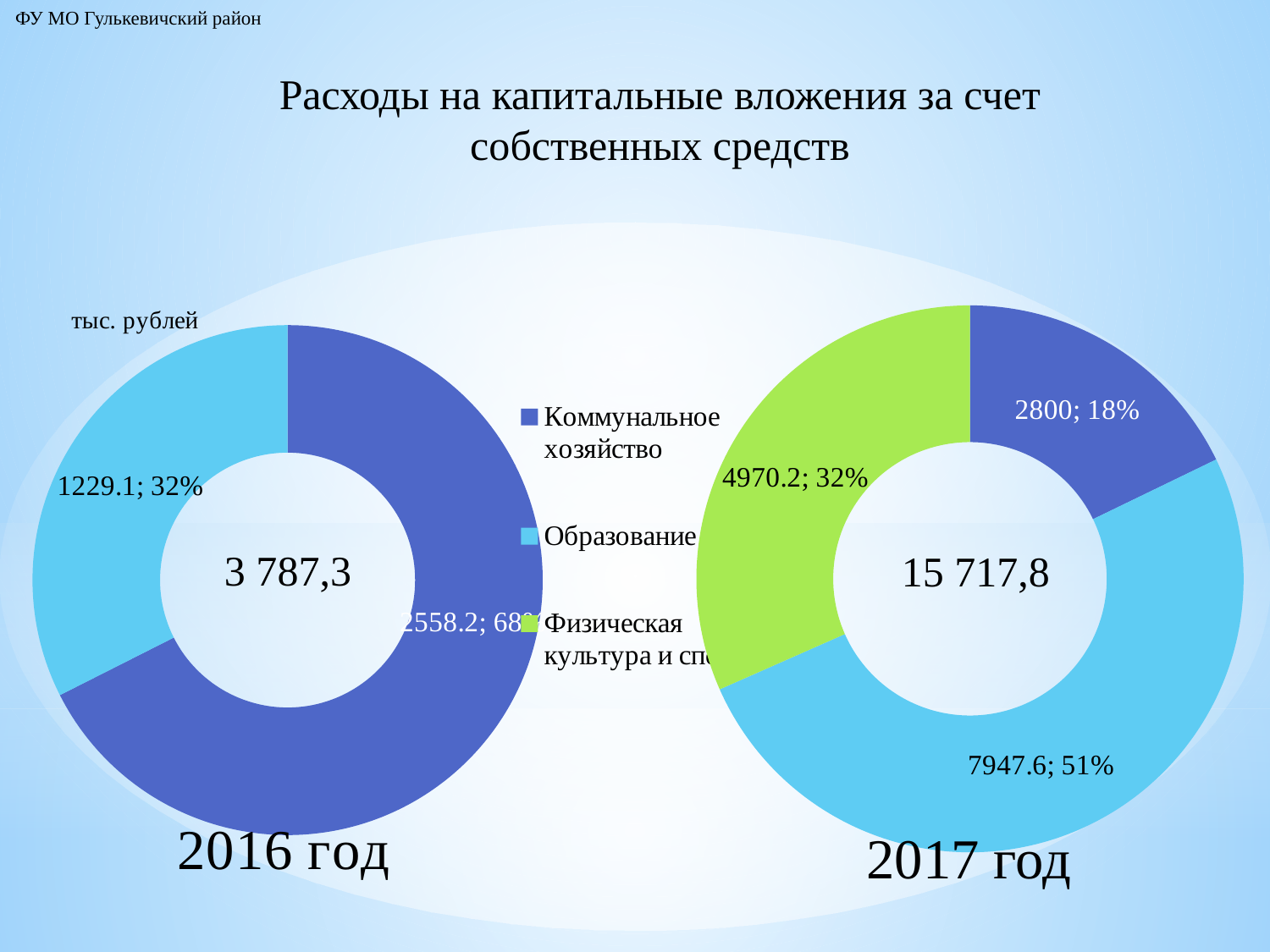
What type of chart is used on this slide? Pie (doughnut) chart How many slices does the 2017 год chart have? 3 How many slices does the 2016 год chart have? 2 On the 2017 год chart, which is larger: Физическая культура и спорт or Коммунальное хозяйство? Физическая культура и спорт On the 2017 год chart, what is the value for Физическая культура и спорт? 4970.2 On the 2016 год chart, what is the value for Образование? 1229.1 On the 2017 год chart, what share of the total does Коммунальное хозяйство represent? 18% On the 2017 год chart, what is the difference between the values for Образование and Физическая культура и спорт? 2977.4 On the 2017 год chart, which category has the smallest slice? Коммунальное хозяйство On the 2017 год chart, which category has the largest slice? Образование On the 2016 год chart, what share of the total does Образование represent? 32% On the 2017 год chart, what is the value for Образование? 7947.6